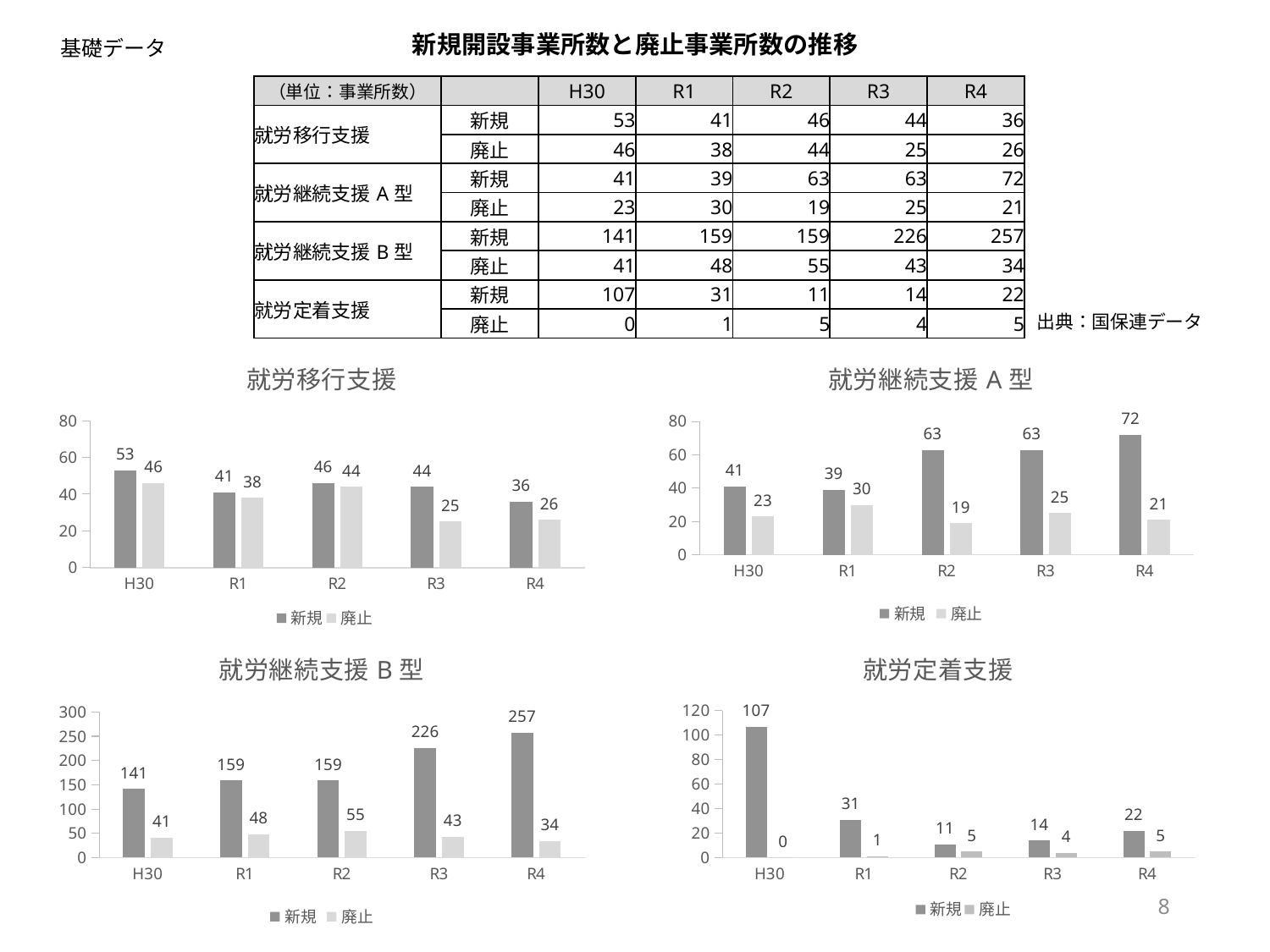
How many series does the legend of the 就労継続支援 B 型 chart list? 2 In the 就労継続支援 A 型 chart, what is the value for 廃止 in R2? 19 In the 就労継続支援 A 型 chart, is the 新規 value for R4 greater or less than 60? greater In the 就労継続支援 B 型 chart, do the 新規 values generally rise or fall from H30 to R4? rise In the 就労移行支援 chart, which is larger in R3: 新規 or 廃止? 新規 How many years are shown on the x axis of the 就労定着支援 chart? 5 What is the title of the chart at the bottom right of the slide? 就労定着支援 What kind of chart is the 就労移行支援 chart? bar chart In the 就労継続支援 B 型 chart, which year has the highest 新規 value? R4 In the 就労定着支援 chart, which year has the lowest 廃止 value? H30 In the 就労移行支援 chart, what is the value for 新規 in H30? 53 In the 就労継続支援 B 型 chart, what is the difference between 新規 and 廃止 in R4? 223